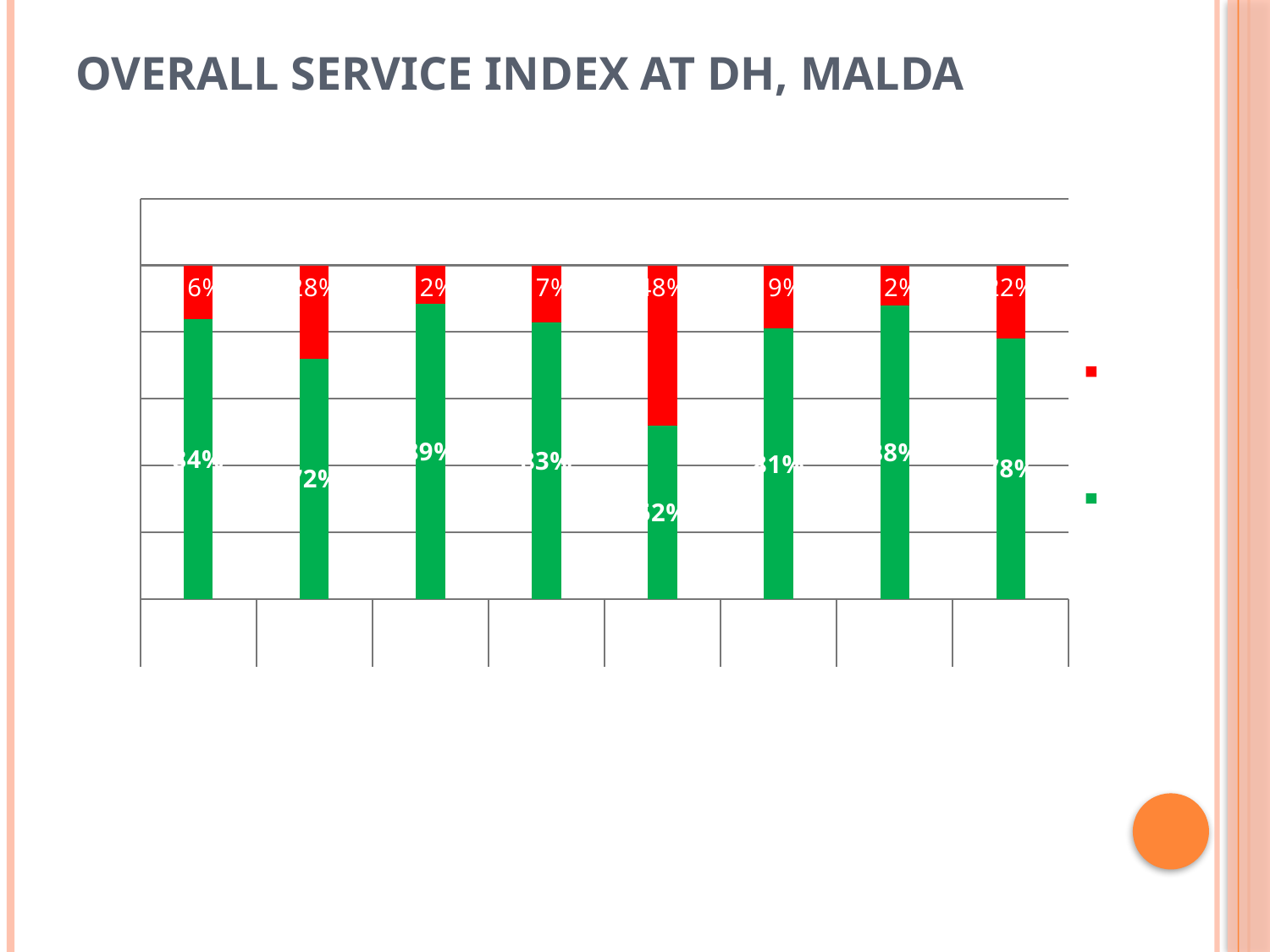
Which has the larger green segment, the second bar from the left or the fifth bar from the left? the second bar In the first bar from the left, which segment is larger, the green or the red? green Which bar, counting from the left, has the largest red segment? the fifth bar What two colours are used for the segments of the stacked bars? green and red What kind of chart is shown on the slide? stacked bar chart How many bars are plotted in the chart? 8 How many series does the legend list? 2 What is the title of the slide? OVERALL SERVICE INDEX AT DH, MALDA Which bar, counting from the left, has the smallest green segment? the fifth bar Which has the larger red segment, the third bar from the left or the fifth bar from the left? the fifth bar Which segment is at the bottom of each stacked bar, green or red? green